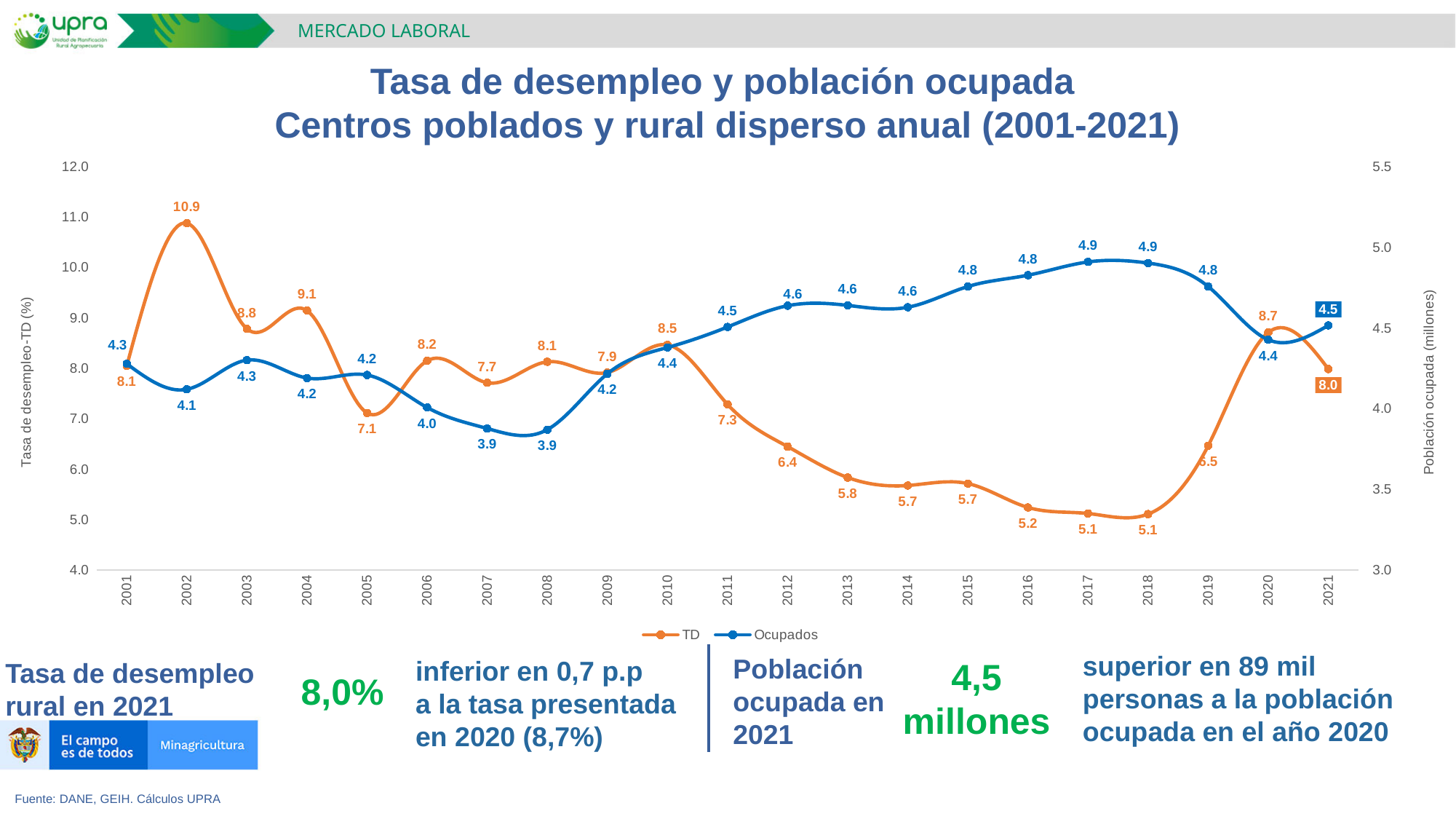
Does the TD series rise or fall from 2012 to 2018? Fall What is the Ocupados value for 2021? 4.5 What kind of chart is shown on the slide? Line chart What are the two series named in the legend? TD and Ocupados How many years are plotted on the x axis? 21 How many series does the legend list? 2 What is the difference between the TD value in 2020 and the TD value in 2021? 0.7 What is the TD value for 2018? 5.1 What is the lowest value shown for the TD series? 5.1 What is the TD value for 2002? 10.9 In which year is the TD series at its highest? 2002 Which is larger, the TD value for 2002 or the TD value for 2004? 2002